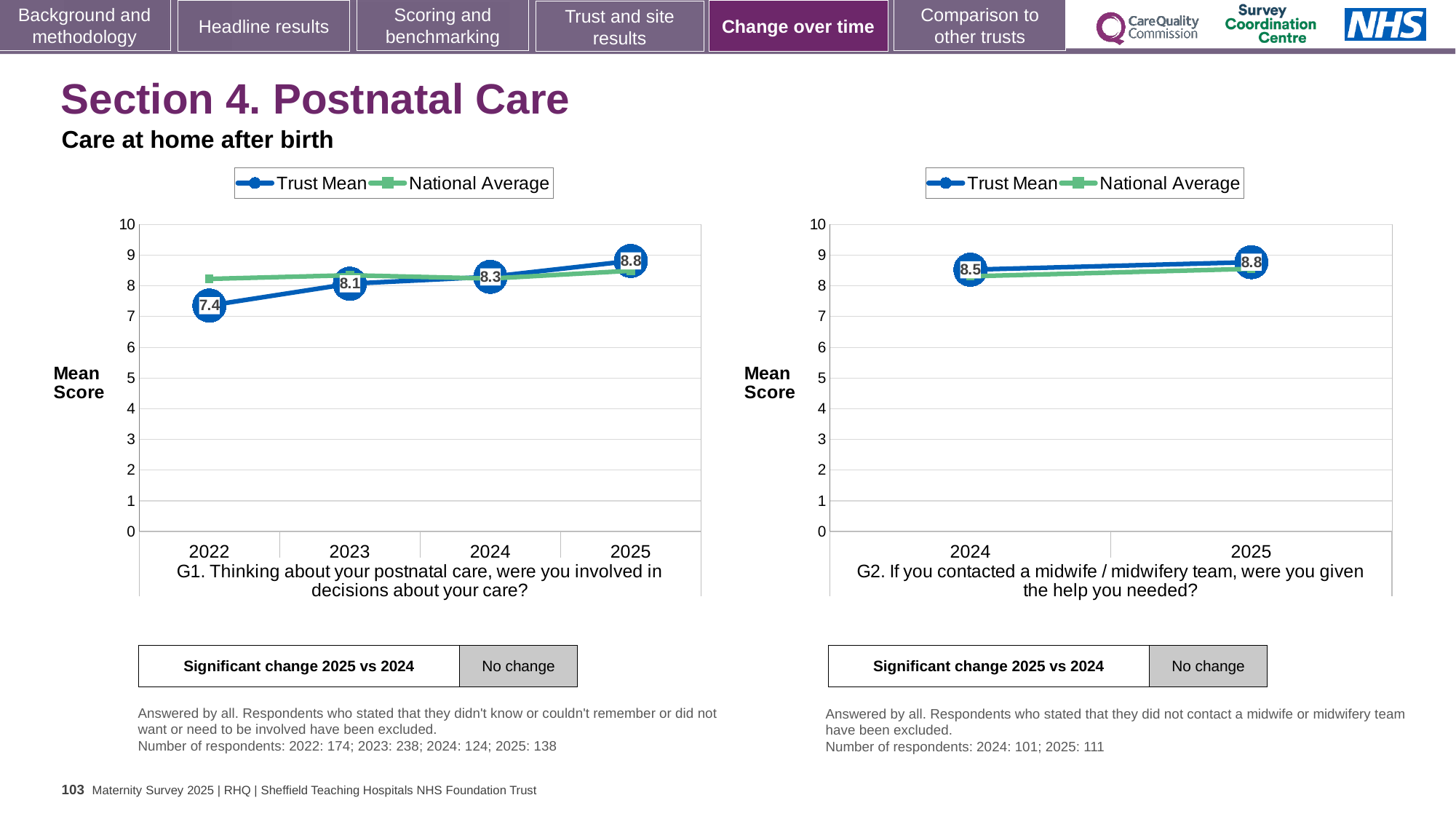
How many series does the legend of the G1 chart on the left list? 2 In the G1 chart on the left, what is the Trust Mean for 2022? 7.4 In the G1 chart on the left, what is the Trust Mean for 2025? 8.8 In the G1 chart on the left, which year has the highest Trust Mean? 2025 In the G1 chart on the left, is the Trust Mean higher in 2023 or 2024? 2024 In the G2 chart on the right, what is the Trust Mean for 2024? 8.5 How many years are shown on the x axis of the G2 chart on the right? 2 In the G1 chart on the left, which year has the lowest Trust Mean? 2022 In the G1 chart on the left, is the National Average for 2022 greater or less than 7? greater Does the Trust Mean in the G1 chart on the left rise or fall from 2022 to 2025? rise In the G1 chart on the left, what is the difference between the Trust Mean for 2025 and 2022? 1.4 In the G2 chart on the right, what is the difference between the Trust Mean for 2025 and 2024? 0.3